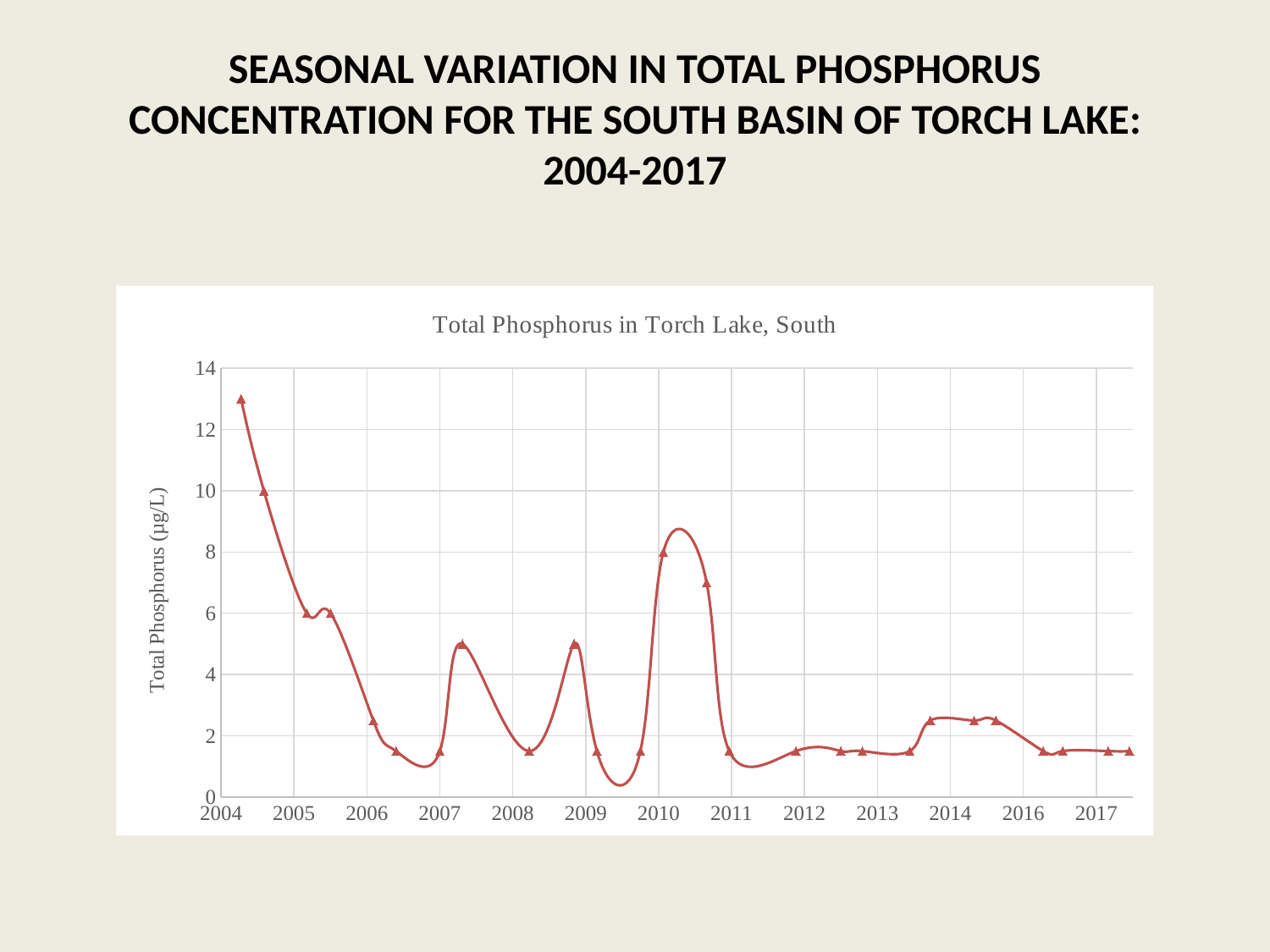
Which is larger: the first data point in 2004 or the highest data point in 2010? the first data point in 2004 Overall, do the total phosphorus values rise or fall from 2004 to 2017? fall What kind of chart is shown on the slide? line chart How many year labels are shown along the x axis? 13 What is the title printed inside the chart area? Total Phosphorus in Torch Lake, South In which year does the chart reach its highest total phosphorus value? 2004 What is the label on the vertical axis of the chart? Total Phosphorus (µg/L) Are the data points in 2017 greater or less than 2? less Are the data points in 2012 greater or less than 4? less Is the first data point in 2004 greater or less than 12? greater